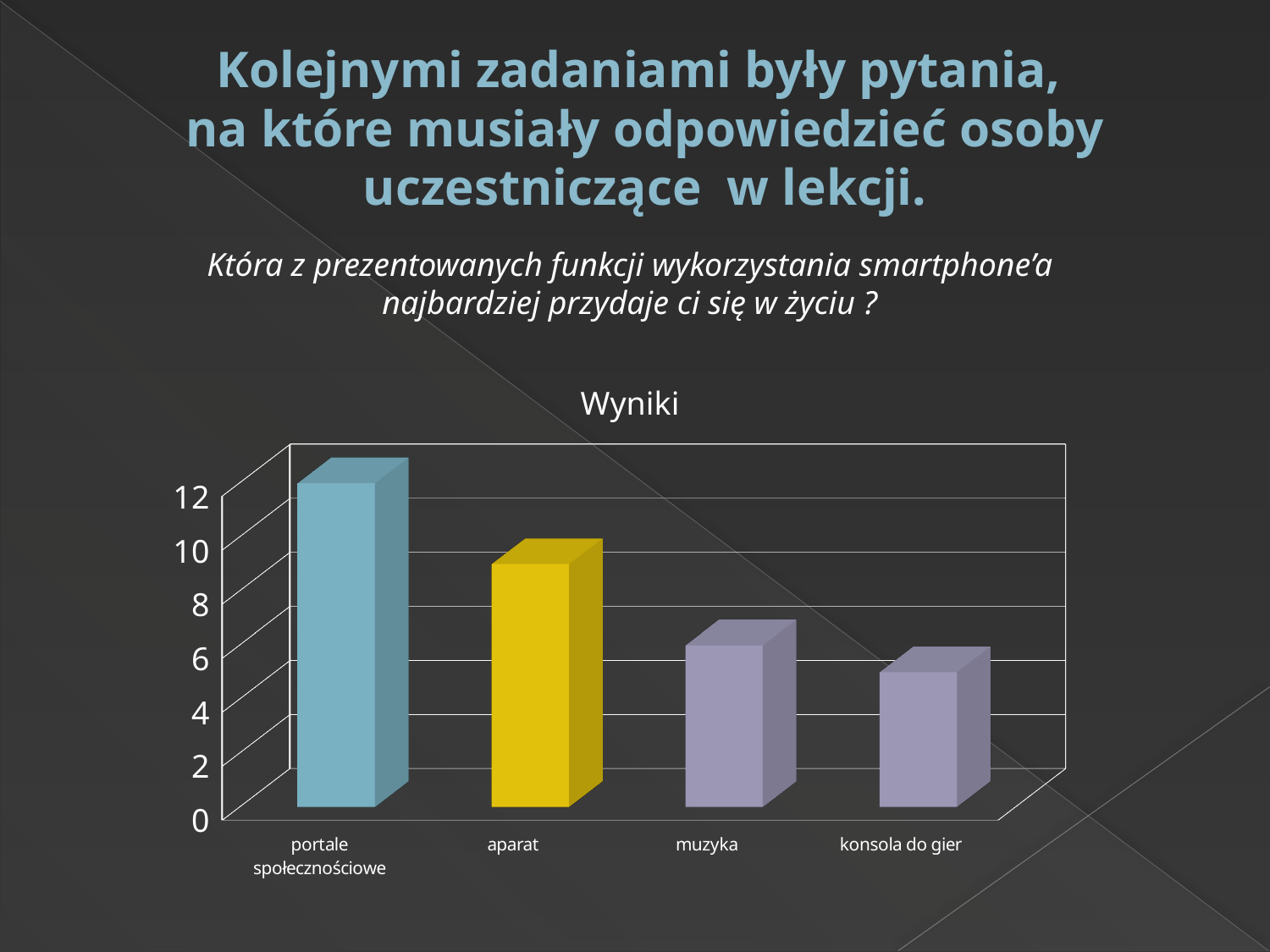
Is the value for aparat greater or less than 10? less What is the title of the chart? Wyniki Which is larger, the value for portale społecznościowe or the value for aparat? portale społecznościowe Which is larger, the value for aparat or the value for muzyka? aparat How many categories are shown on the chart? 4 Which category has the highest value? portale społecznościowe Is the value for portale społecznościowe greater or less than 10? greater What kind of chart is shown on the slide? bar chart What colour is the bar for aparat? yellow Is the value for konsola do gier greater or less than 6? less Do the values rise or fall from left to right across the categories? fall Which category has the lowest value? konsola do gier